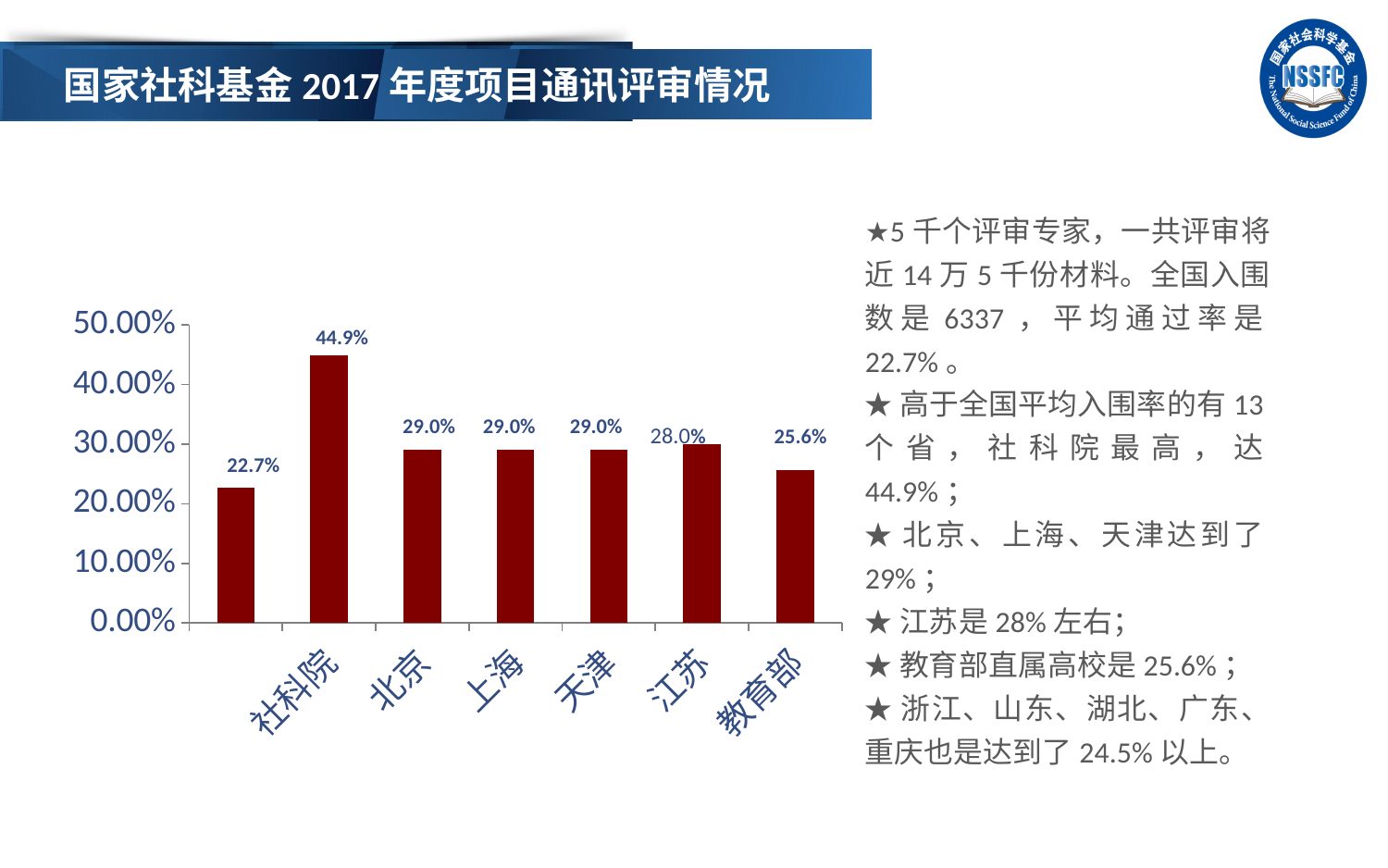
Is the value for 社科院 greater or less than 40.00%? greater What is the value for 教育部 in the chart? 25.6% What is the difference between the values for 天津 and 江苏? 1.0 percentage point How many bars are plotted in the chart? 7 What is the value for 北京 in the chart? 29.0% What is the value for 江苏 in the chart? 28.0% Which is larger, the value for 江苏 or the value for 教育部? 江苏 What kind of chart is shown on the slide? bar chart Which labeled category has the highest value in the chart? 社科院 What is the value for 社科院 in the chart? 44.9% What is the title of the slide containing the chart? 国家社科基金 2017 年度项目通讯评审情况 What is the difference between the values for 社科院 and 教育部? 19.3 percentage points